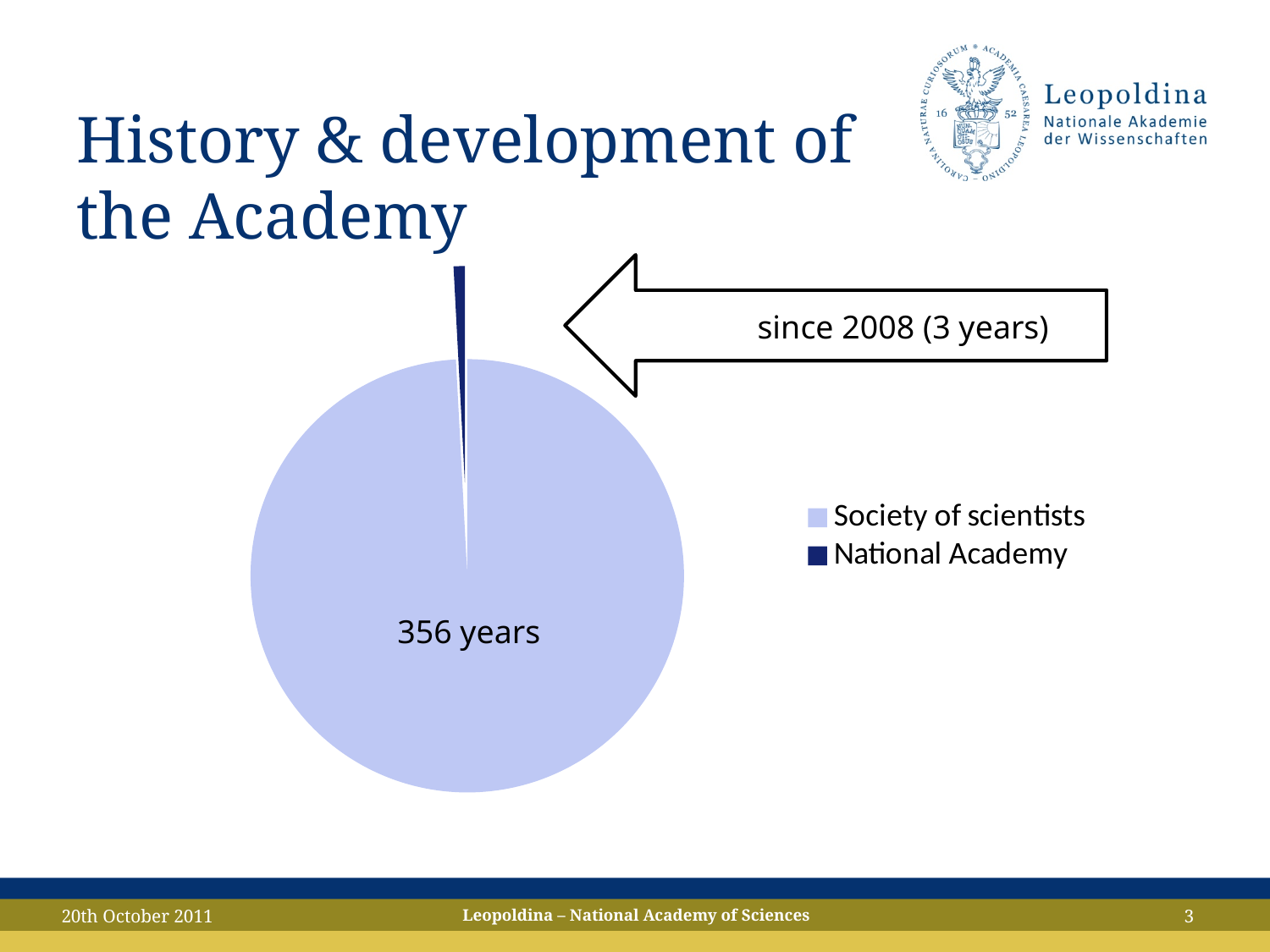
Which is larger, the Society of scientists slice or the National Academy slice? Society of scientists Since what year has the Academy been a National Academy, according to the callout on the chart? 2008 What is the difference in years between the Society of scientists slice and the National Academy slice? 353 years How many slices does the pie chart have? 2 What are the two legend entries of the pie chart? Society of scientists; National Academy How many years does the slide give for the National Academy slice? 3 years Which slice of the pie chart is the smallest? National Academy What value is shown for the Society of scientists slice? 356 years What is the total number of years represented by both slices of the pie chart? 359 years Which slice of the pie chart is the largest? Society of scientists What kind of chart is shown on the slide? pie chart How many entries does the legend of the pie chart list? 2